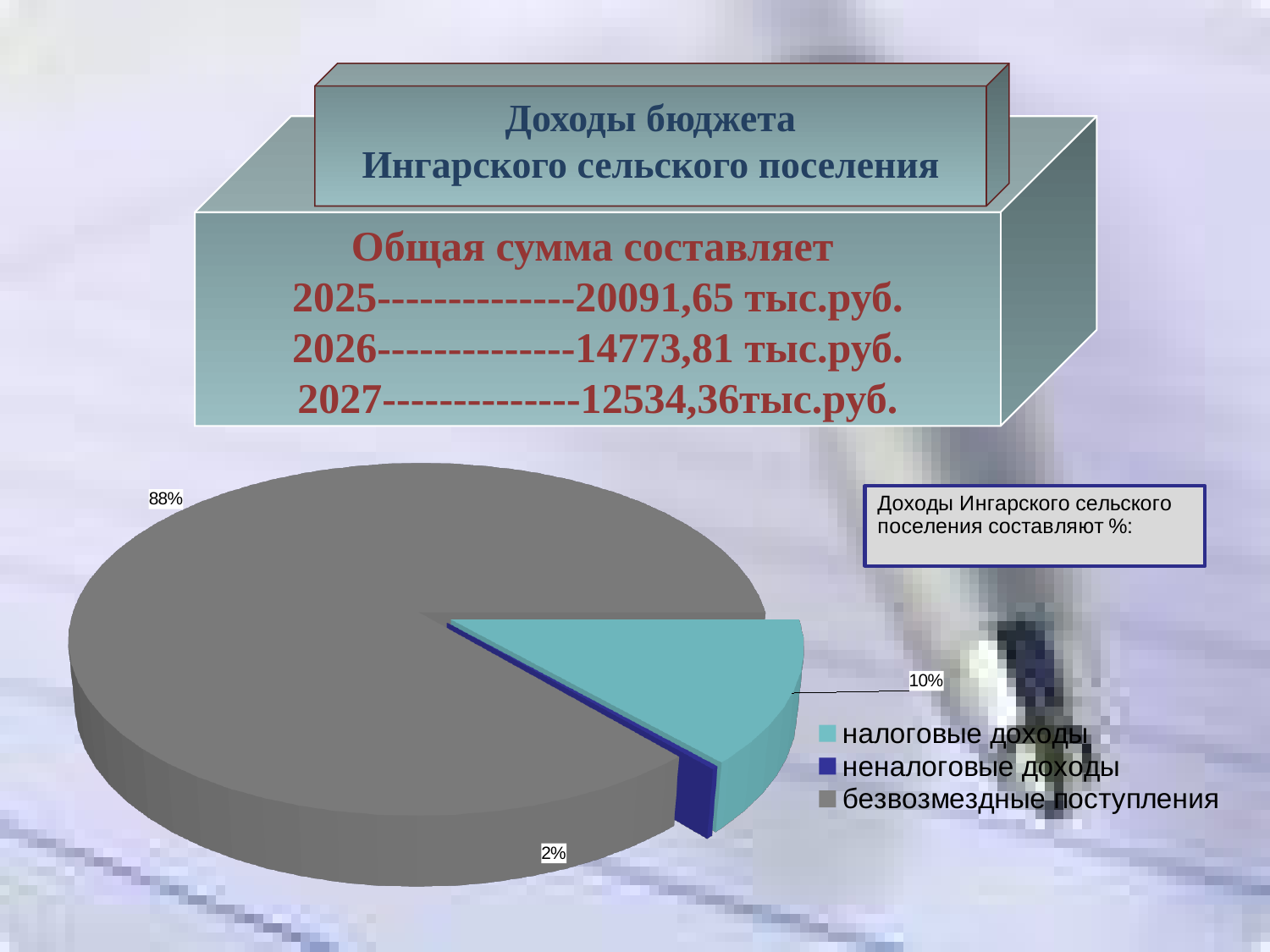
What is the combined share of налоговые доходы and неналоговые доходы? 12% How many categories does the pie chart show? 3 Which is larger, the share for налоговые доходы or the share for неналоговые доходы? налоговые доходы How many entries does the legend list? 3 Which category has the largest slice of the pie? безвозмездные поступления What kind of chart is shown on the slide? pie chart Which category has the smallest slice of the pie? неналоговые доходы What share of the pie does неналоговые доходы have? 2% What is the difference in percentage points between безвозмездные поступления and налоговые доходы? 78 What share of the pie does безвозмездные поступления have? 88% What colour is the slice for безвозмездные поступления? grey What share of the pie does налоговые доходы have? 10%